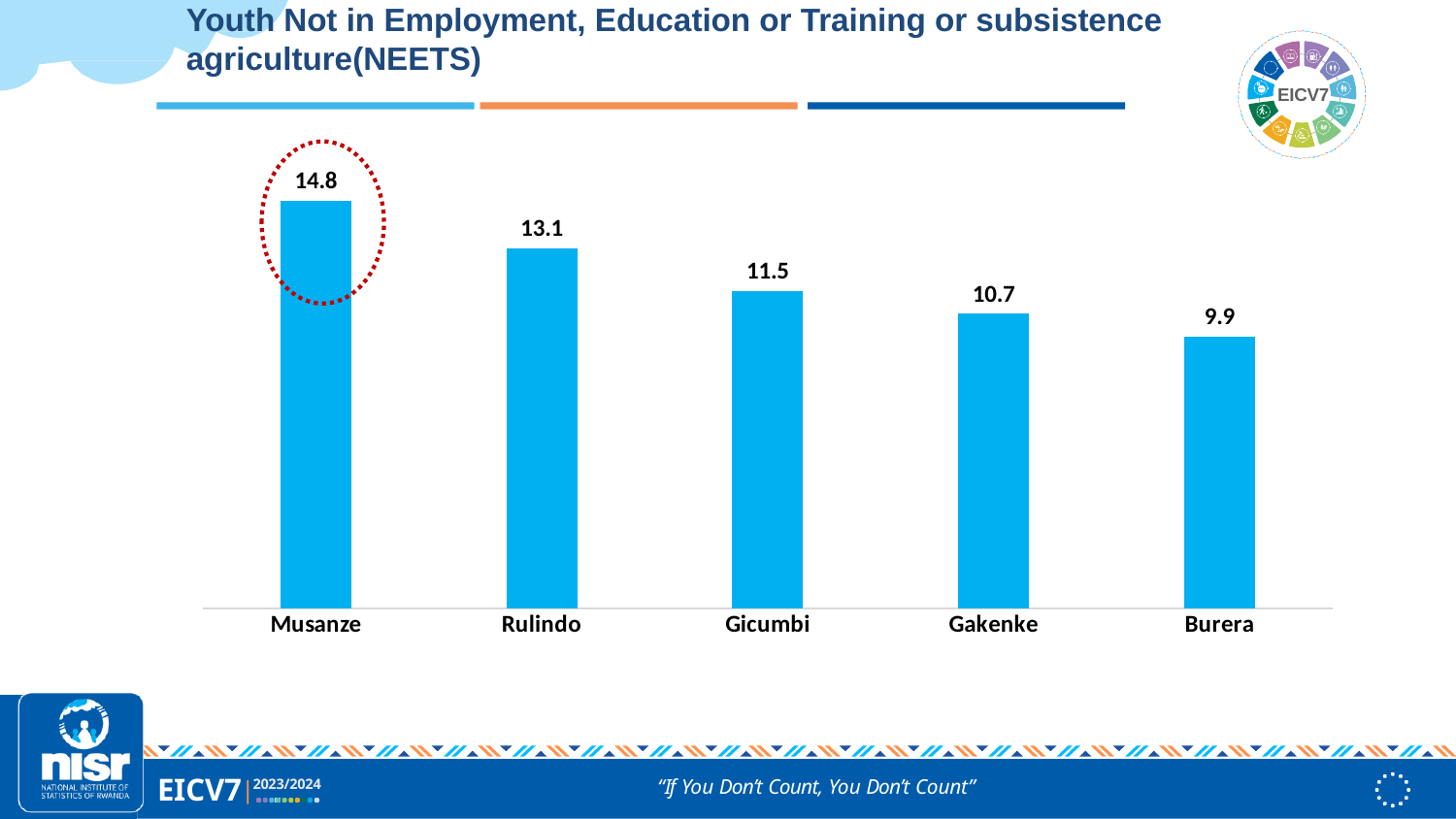
Do the values rise or fall from left to right across the districts? Fall What is the value for Musanze? 14.8 Which district has the lowest value? Burera What is the difference between the values for Rulindo and Gakenke? 2.4 What is the difference between the values for Musanze and Burera? 4.9 Which district has the highest value? Musanze Which bar is circled with a red dotted line? Musanze Which is larger, the value for Rulindo or the value for Gicumbi? Rulindo How many districts are shown in the chart? 5 What is the value for Burera? 9.9 What kind of chart is shown on the slide? Bar chart What is the value for Gicumbi? 11.5